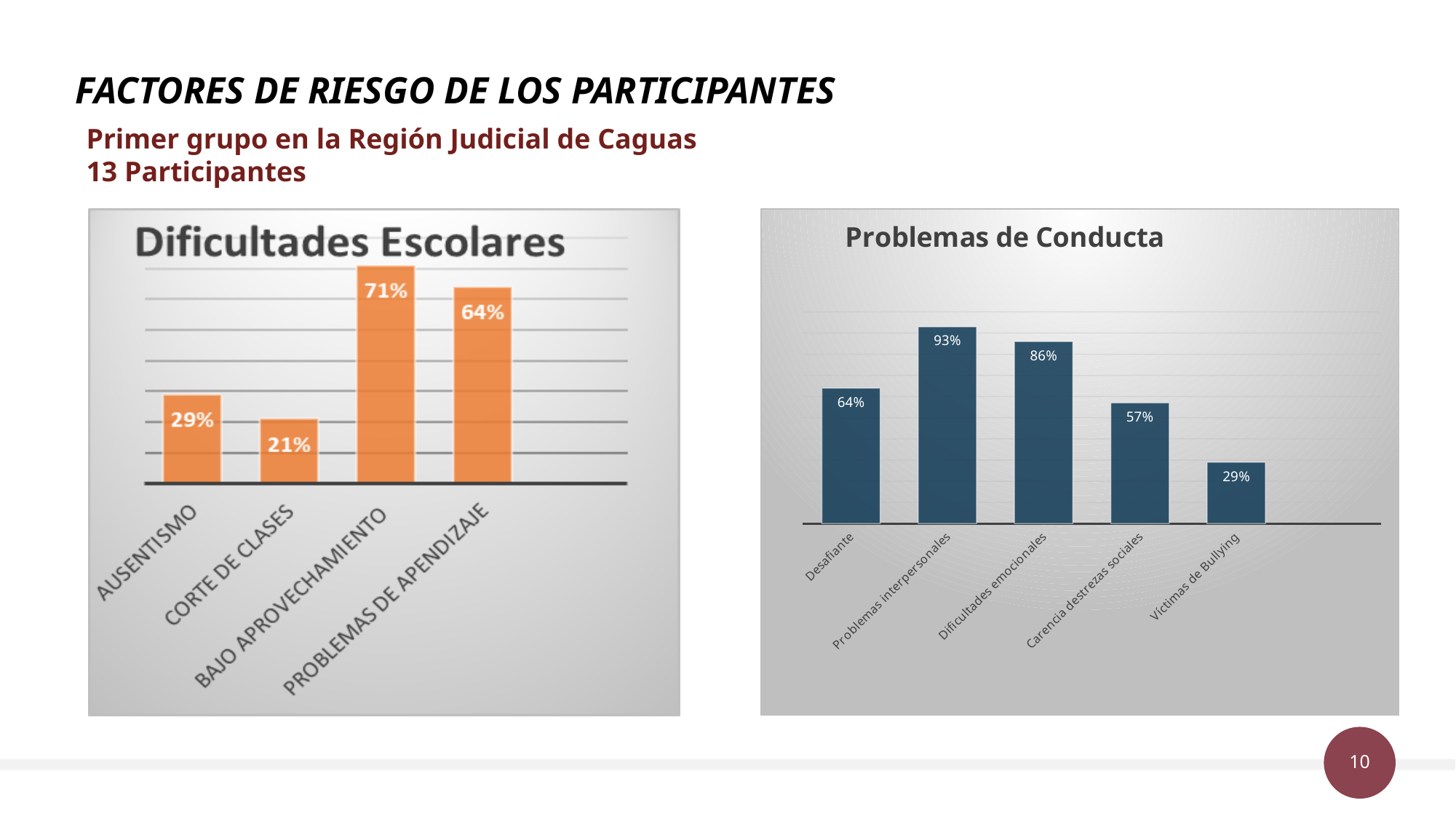
In the "Dificultades Escolares" chart, what is the value for CORTE DE CLASES? 21% In the "Dificultades Escolares" chart, how many categories are shown? 4 In the "Problemas de Conducta" chart, which category has the highest value? Problemas interpersonales In the "Problemas de Conducta" chart, what is the value for Dificultades emocionales? 86% In the "Problemas de Conducta" chart, what is the value for Carencia destrezas sociales? 57% In the "Dificultades Escolares" chart, which category has the lowest value? CORTE DE CLASES In the "Problemas de Conducta" chart, what is the difference between Problemas interpersonales and Víctimas de Bullying? 64% In the "Problemas de Conducta" chart, which category has the lowest value? Víctimas de Bullying In the "Dificultades Escolares" chart, what is the value for BAJO APROVECHAMIENTO? 71% What type of chart is the "Problemas de Conducta" chart? Bar chart In the "Problemas de Conducta" chart, which is larger: Desafiante or Carencia destrezas sociales? Desafiante In the "Dificultades Escolares" chart, what is the difference between BAJO APROVECHAMIENTO and AUSENTISMO? 42%